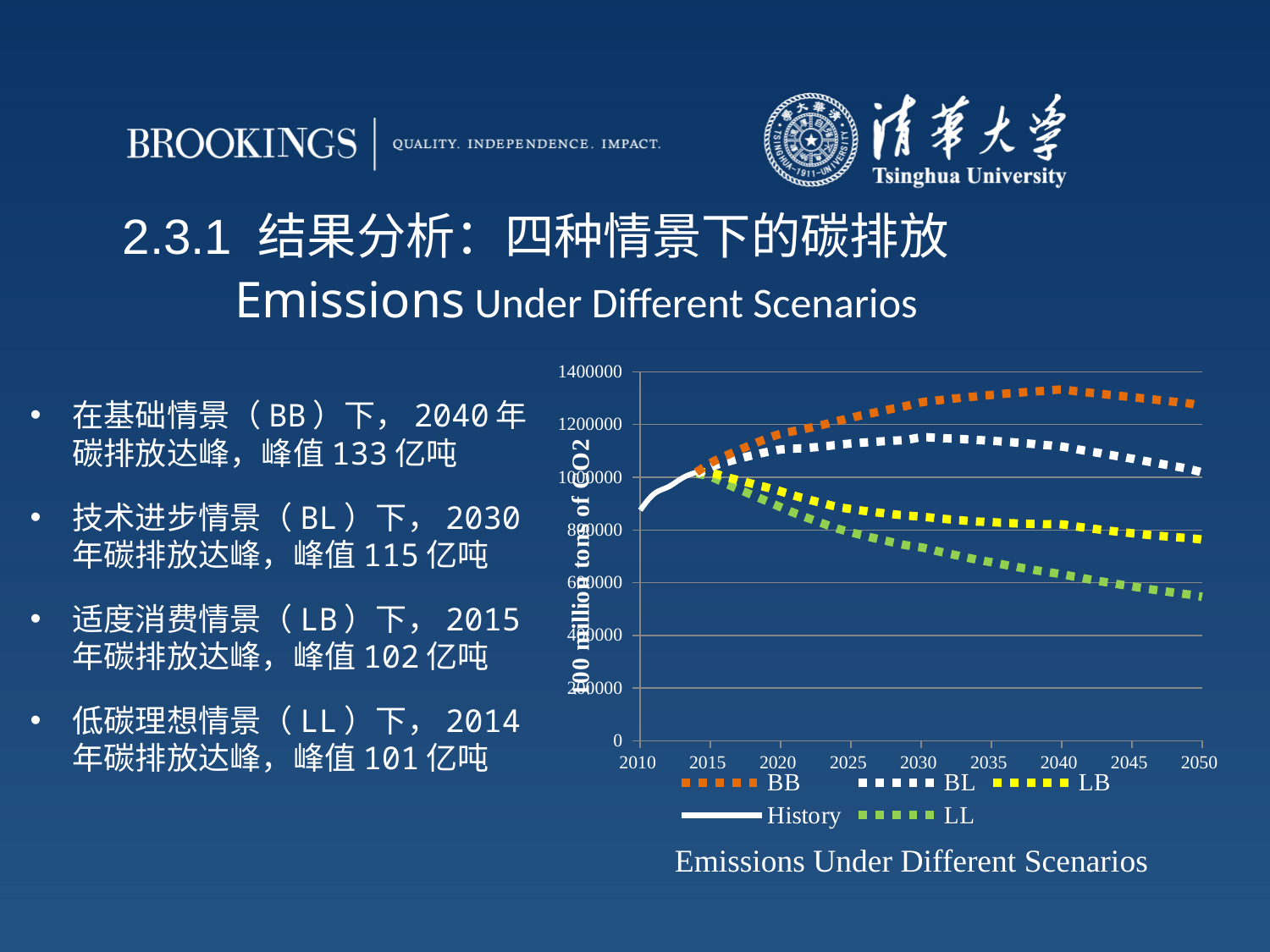
Is the value of the LB series in 2050 greater or less than 800000? less What are the series names listed in the chart legend? BB, BL, LB, History, LL How many series does the chart legend list? 5 Is the value of the BB series in 2050 greater or less than 1200000? greater Which series has the highest value in 2050? BB Does the LL series rise or fall between 2015 and 2050? fall Is the value of the LL series in 2050 greater or less than 600000? less What kind of chart is shown on the slide? line chart What is the last year shown on the x axis? 2050 In 2050, which series has the larger value, BB or LL? BB What is the title shown below the chart? Emissions Under Different Scenarios Which series has the lowest value in 2050? LL